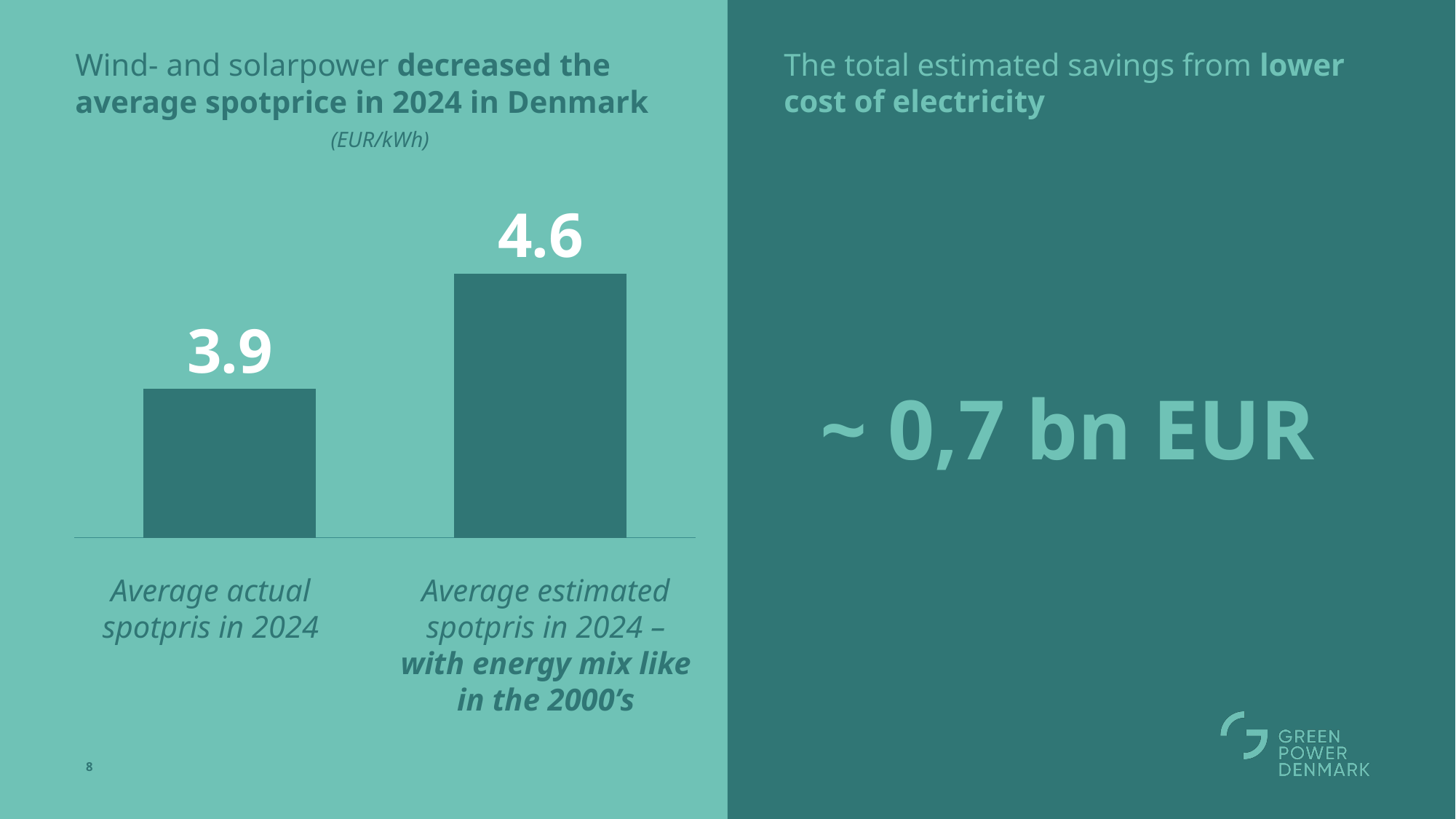
What is the title of the chart? Wind- and solarpower decreased the average spotprice in 2024 in Denmark Which is larger: the average actual spotprice in 2024 or the average estimated spotprice with an energy mix like in the 2000's? Average estimated spotpris in 2024 – with energy mix like in the 2000's Which bar is the lowest? Average actual spotpris in 2024 What kind of chart is shown on the slide? Bar chart How many bars are shown in the chart? 2 What is the value for 'Average actual spotpris in 2024'? 3.9 Which bar is the highest? Average estimated spotpris in 2024 – with energy mix like in the 2000's What is the value for 'Average estimated spotpris in 2024 – with energy mix like in the 2000's'? 4.6 What unit is given for the values in the chart? EUR/kWh What is the difference between the estimated spotprice (4.6) and the actual spotprice (3.9)? 0.7